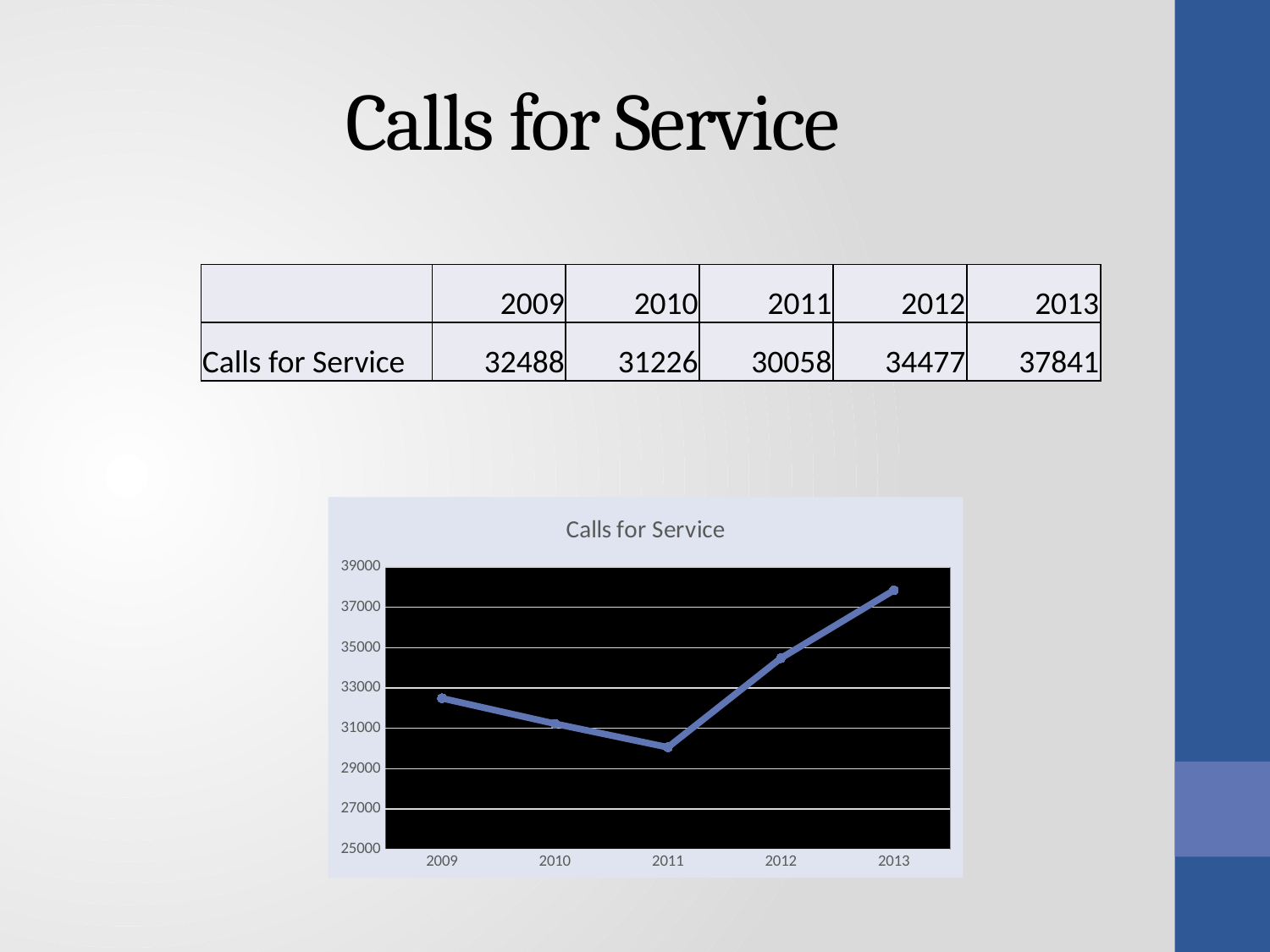
How many years are plotted on the x axis of the chart? 5 What is the value for Calls for Service in 2011? 30058 What is the difference in Calls for Service between 2013 and 2012? 3364 What type of chart is shown on the slide? line chart What is the value for Calls for Service in 2009? 32488 What is the difference in Calls for Service between 2012 and 2011? 4419 What is the title of the chart? Calls for Service Is the value for 2012 greater or less than 33000? greater What is the value for Calls for Service in 2013? 37841 Which year has the highest number of Calls for Service? 2013 Which year has the lowest number of Calls for Service? 2011 Which year has more Calls for Service, 2009 or 2010? 2009